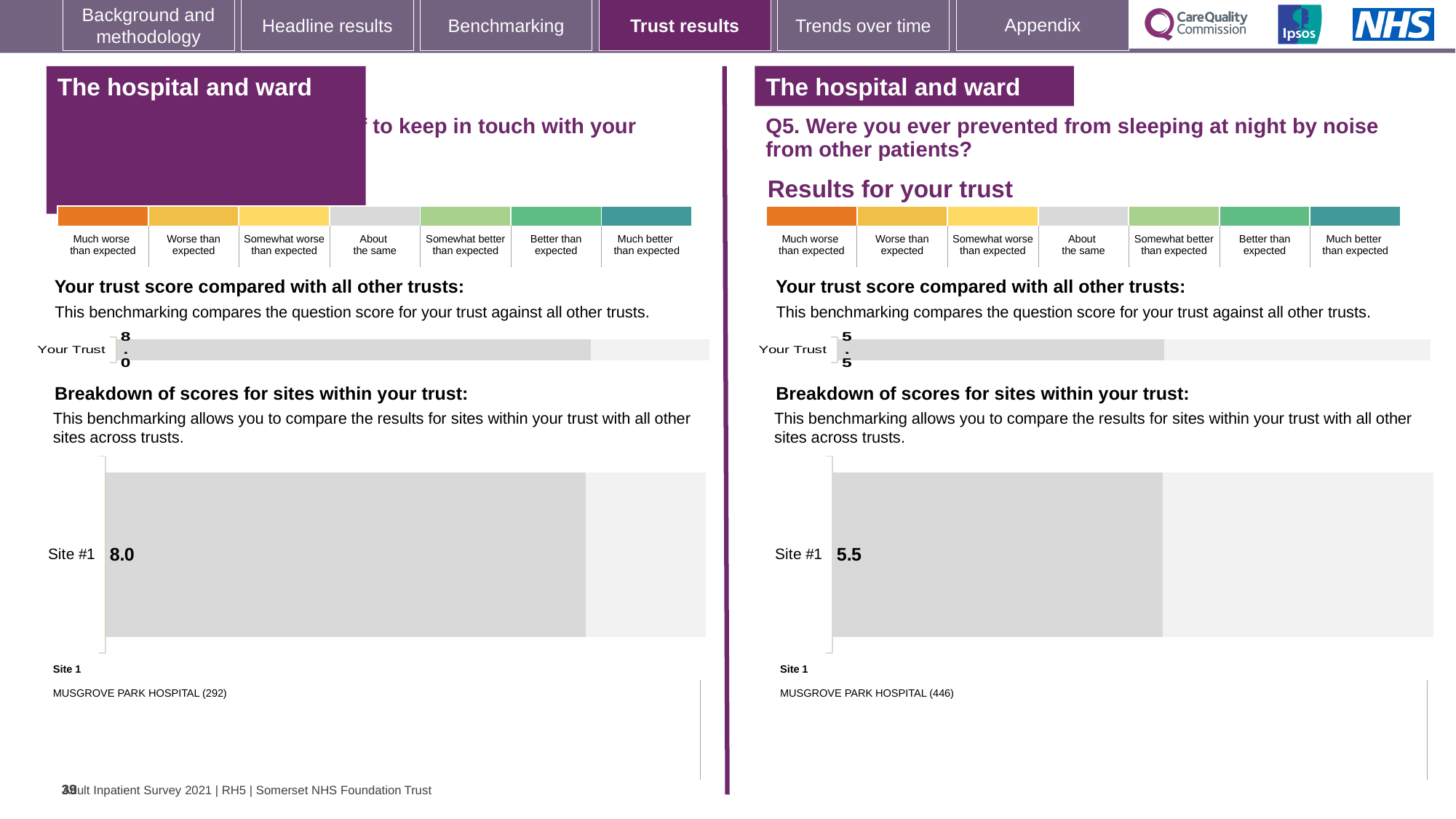
How many sites are shown in the 'Breakdown of scores for sites within your trust' chart on the left-hand panel? 1 On the right-hand panel (Q5, noise from other patients), what is the score shown for Your Trust? 5.5 On the right-hand panel (Q5), which hospital is listed as Site 1? MUSGROVE PARK HOSPITAL (446) What is the difference between the Site #1 score on the left-hand panel and the Site #1 score on the right-hand panel (Q5)? 2.5 On the left-hand panel, what is the score shown for Site #1? 8.0 On the right-hand panel (Q5, noise from other patients), what is the score shown for Site #1? 5.5 What is the difference between the Your Trust score on the left-hand panel and the Your Trust score on the right-hand panel (Q5)? 2.5 On the left-hand panel, what is the score shown for Your Trust? 8.0 On the left-hand panel, which hospital is listed as Site 1? MUSGROVE PARK HOSPITAL (292) Which is larger: the Site #1 score on the left-hand panel or the Site #1 score on the right-hand panel (Q5)? Left-hand panel How many sites are shown in the 'Breakdown of scores for sites within your trust' chart on the right-hand panel (Q5)? 1 What type of chart is used to show the Site #1 score on the right-hand panel (Q5)? Bar chart